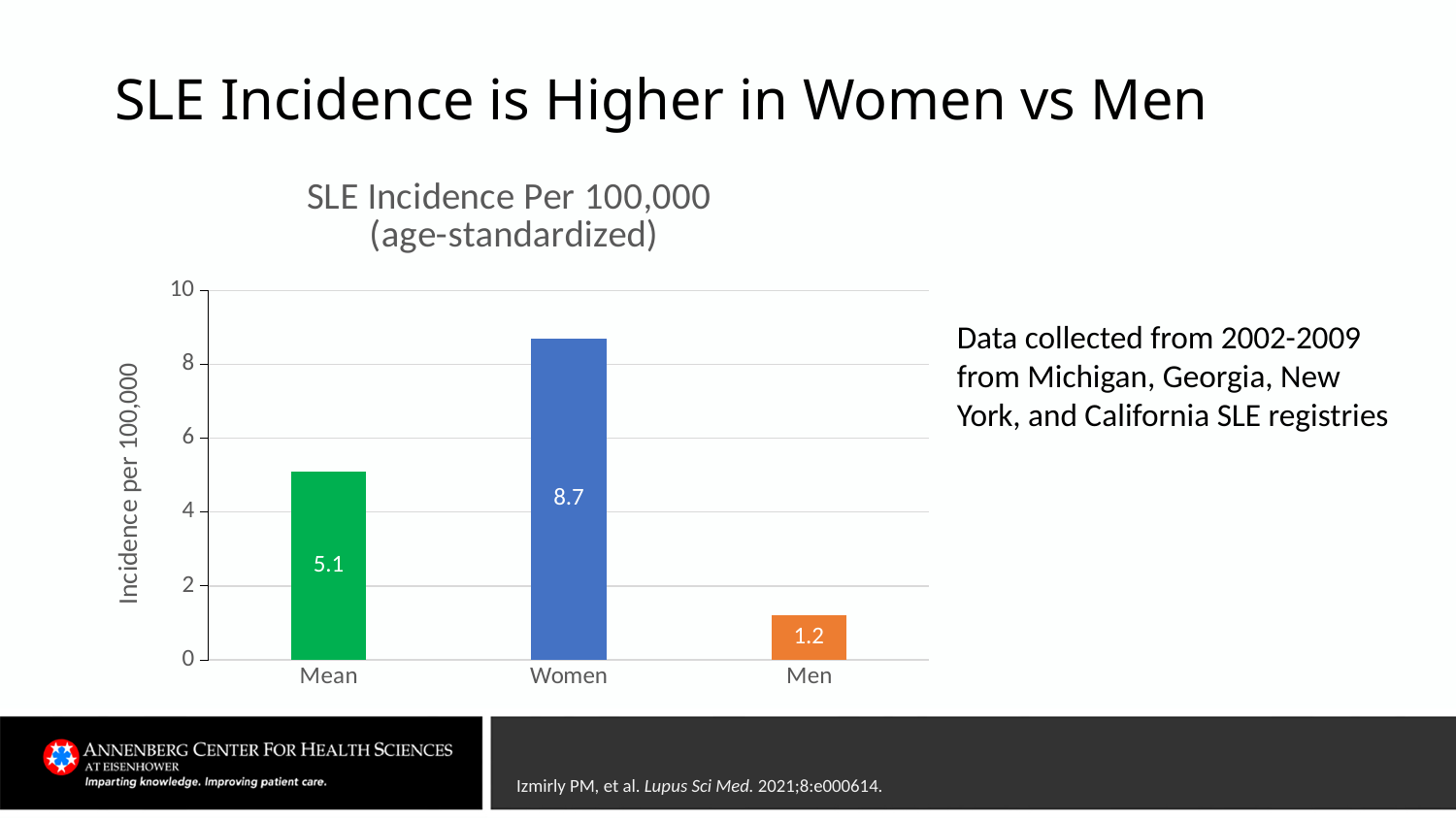
Which category has the lowest incidence? Men What is the title of the chart? SLE Incidence Per 100,000 (age-standardized) What is the value of the Mean bar? 5.1 Which is larger, the incidence for Women or for Men? Women What is the difference between the Women value and the Mean value? 3.6 What is the SLE incidence per 100,000 for Men? 1.2 Which category has the highest incidence? Women How many categories are shown on the x axis? 3 Is the value for Mean greater or less than 4? greater What is the SLE incidence per 100,000 for Women? 8.7 What kind of chart is shown on the slide? Bar chart What is the difference between the incidence for Women and for Men? 7.5